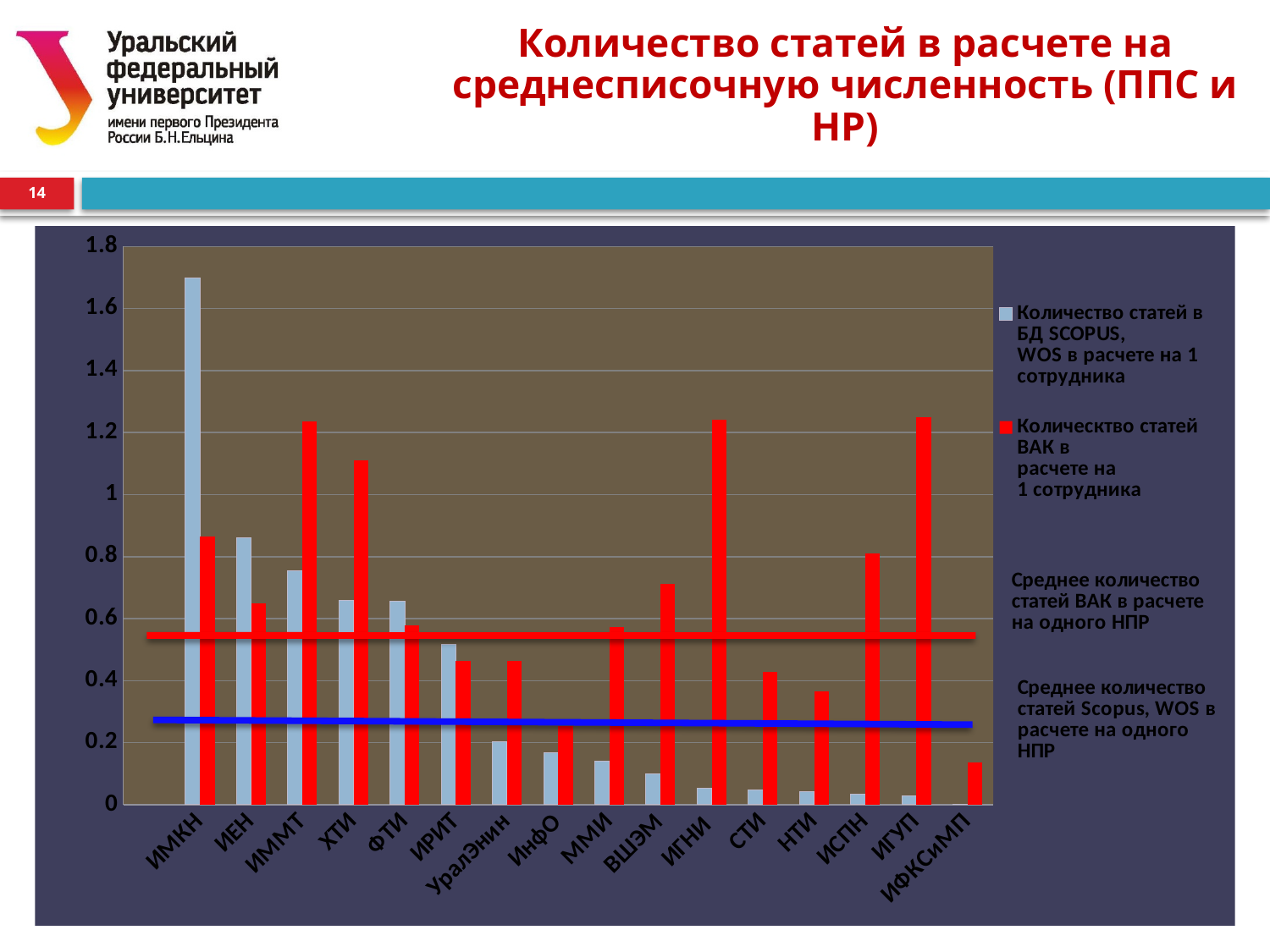
How many series does the legend list? 2 Is the SCOPUS, WOS value for ИГНИ greater or less than 0.2? less For ИМКН, which is larger: the SCOPUS, WOS value or the ВАК value? SCOPUS, WOS What kind of chart is shown on the slide? bar chart Which institute has the lowest value for 'Количество статей ВАК в расчете на 1 сотрудника'? ИФКСиМП Is the ВАК value for ХТИ greater or less than 1? greater Which institute has the highest value for 'Количество статей в БД SCOPUS, WOS в расчете на 1 сотрудника'? ИМКН For ИГНИ, which is larger: the SCOPUS, WOS value or the ВАК value? ВАК Is the ВАК value for ИСПН greater or less than 0.6? greater Do the SCOPUS, WOS values generally rise or fall from left to right along the x axis? fall How many institutes (categories) are shown along the x axis? 16